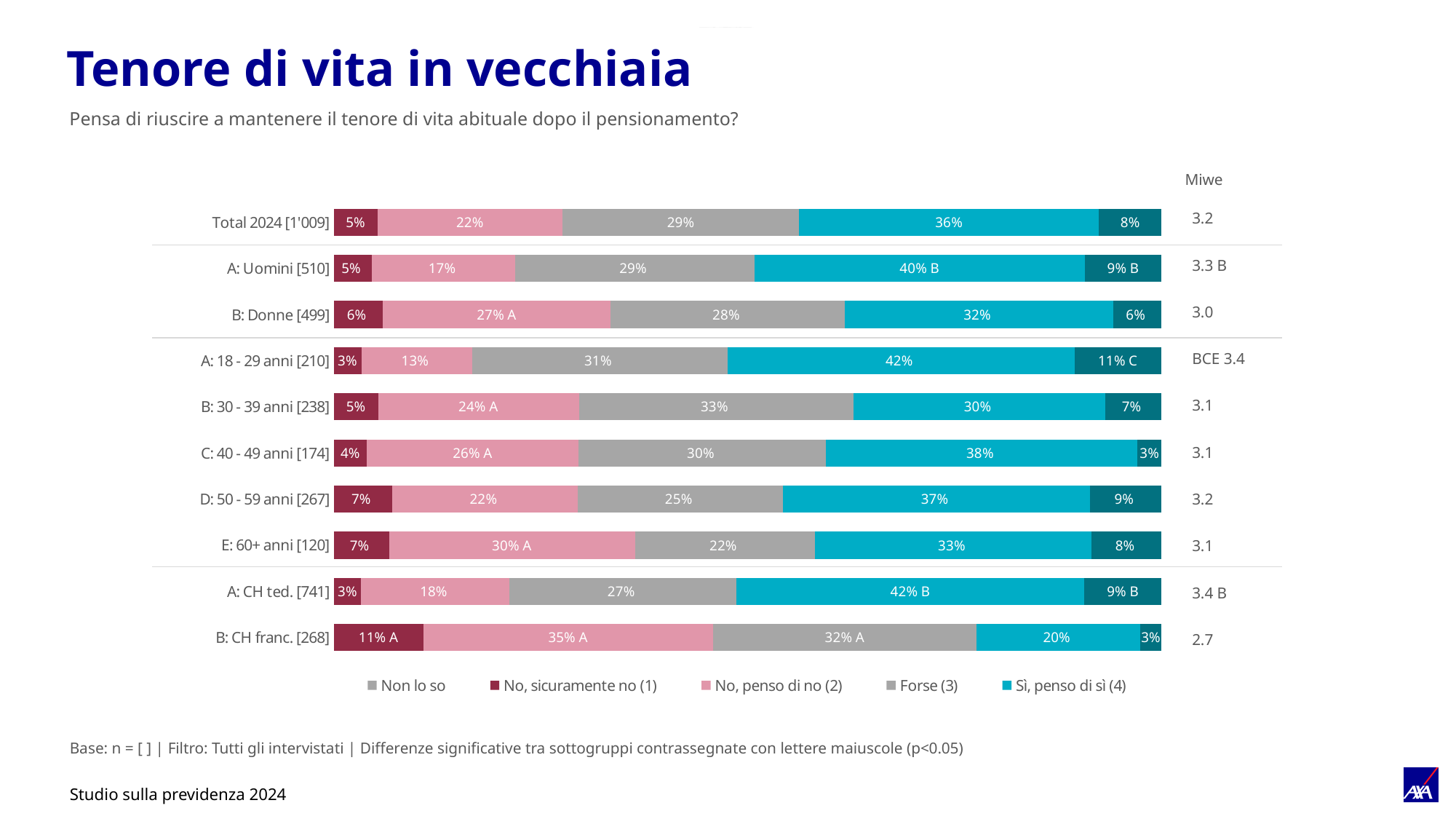
What is the value of "No, sicuramente no (1)" for D: 50 - 59 anni [267]? 7% How many categories (rows) are plotted in the chart? 10 What is the value of "Forse (3)" for B: 30 - 39 anni [238]? 33% What kind of chart is shown on the slide? Stacked bar chart How many series does the legend list? 5 What is the Miwe value shown for B: CH franc. [268]? 2.7 What is the title of the slide? Tenore di vita in vecchiaia Which category has the lowest value for "No, penso di no (2)"? A: 18 - 29 anni [210] What is the value of "Sì, penso di sì (4)" for Total 2024 [1'009]? 36% Which category has the highest value for "No, sicuramente no (1)"? B: CH franc. [268] Which has the larger "Forse (3)" value, D: 50 - 59 anni [267] or E: 60+ anni [120]? D: 50 - 59 anni [267] What is the difference in "Sì, penso di sì (4)" between A: Uomini [510] and B: Donne [499]? 8 percentage points